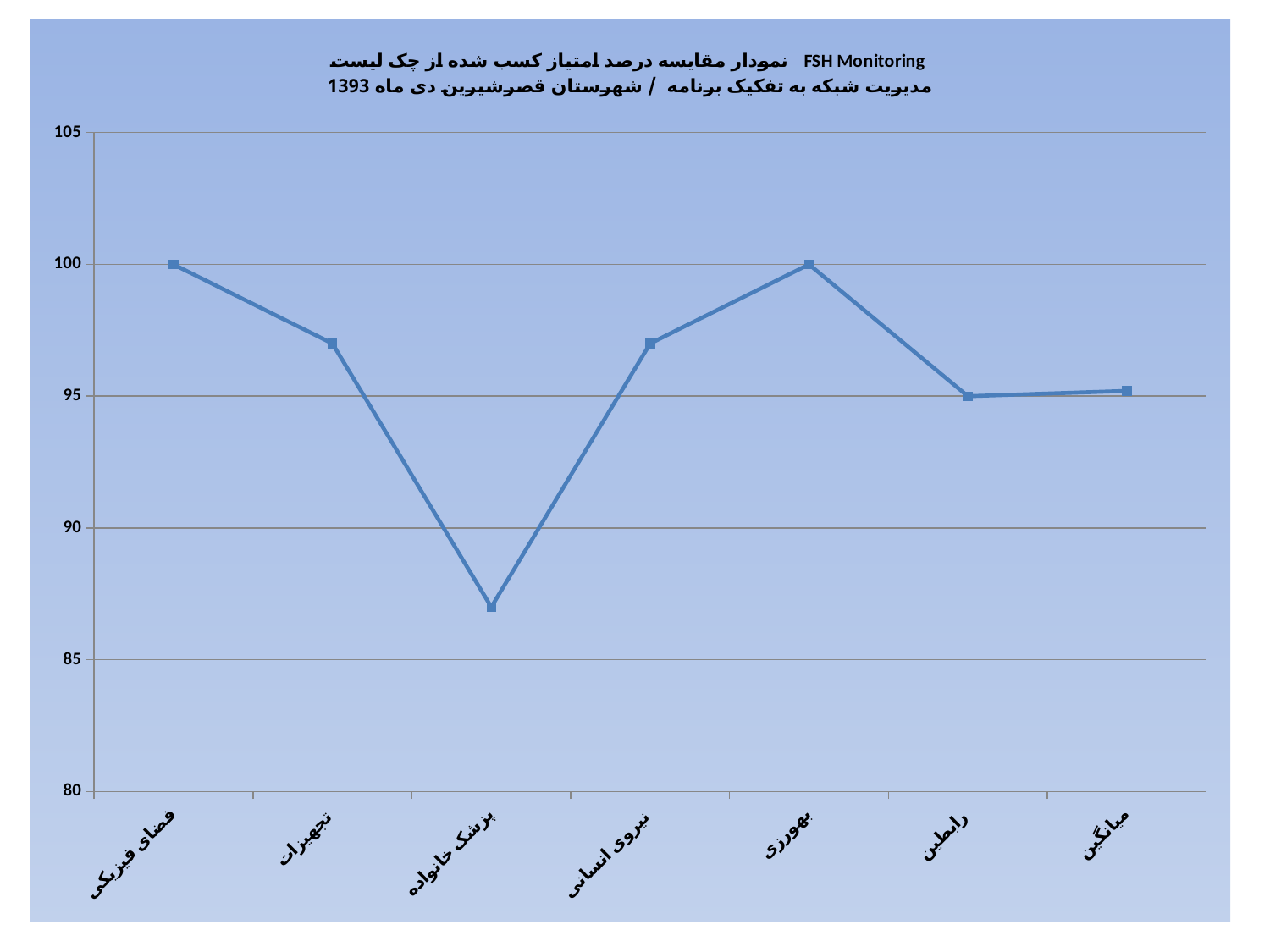
What is the value for فضای فیزیکی? 100 What type of chart is shown on the slide? line chart Is the value for نیروی انسانی greater or less than 100? less Which is larger, the value for تجهیزات or the value for پزشک خانواده? تجهیزات Is the value for پزشک خانواده greater or less than 90? less What is the value for بهورزی? 100 What is the value for رابطین? 95 How many categories are plotted along the x axis? 7 Which English phrase appears in the chart title? FSH Monitoring Do the values rise or fall from فضای فیزیکی to پزشک خانواده? fall Which category has the lowest value? پزشک خانواده Is the value for تجهیزات greater or less than 95? greater